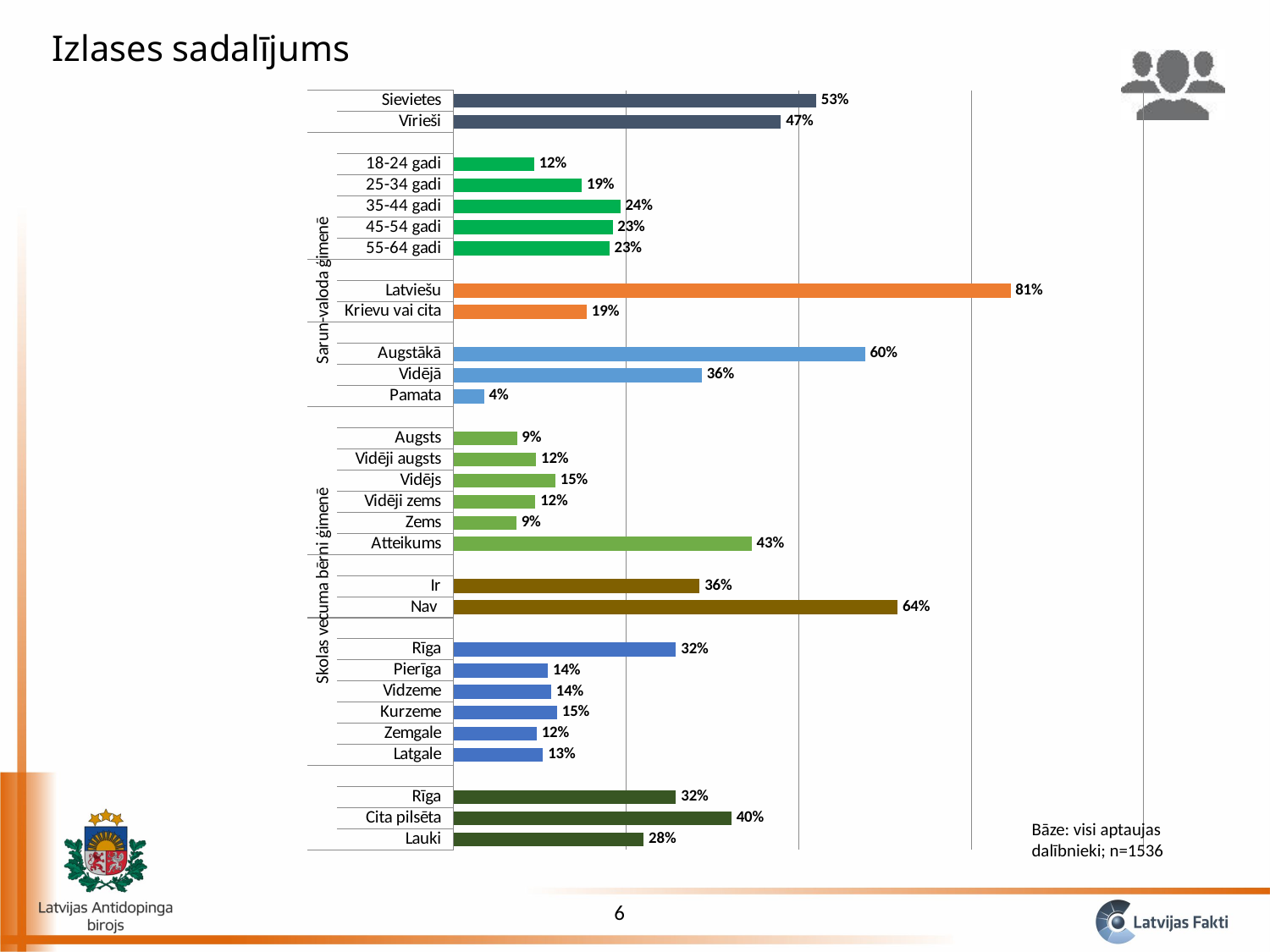
What kind of chart is shown on the slide? bar chart What is the difference between the values for Nav and Ir? 28% What is the value for Latviešu? 81% Which category has the lowest value in the chart? Pamata Which category has the highest value in the chart? Latviešu What is the value for Sievietes? 53% What is the value for Pamata? 4% What is the difference between the values for Sievietes and Vīrieši? 6% Among the age groups (18-24 gadi to 55-64 gadi), which has the highest value? 35-44 gadi What is the title of the slide? Izlases sadalījums What is the value for Cita pilsēta? 40% Which is larger, the value for Augstākā or the value for Vidējā? Augstākā